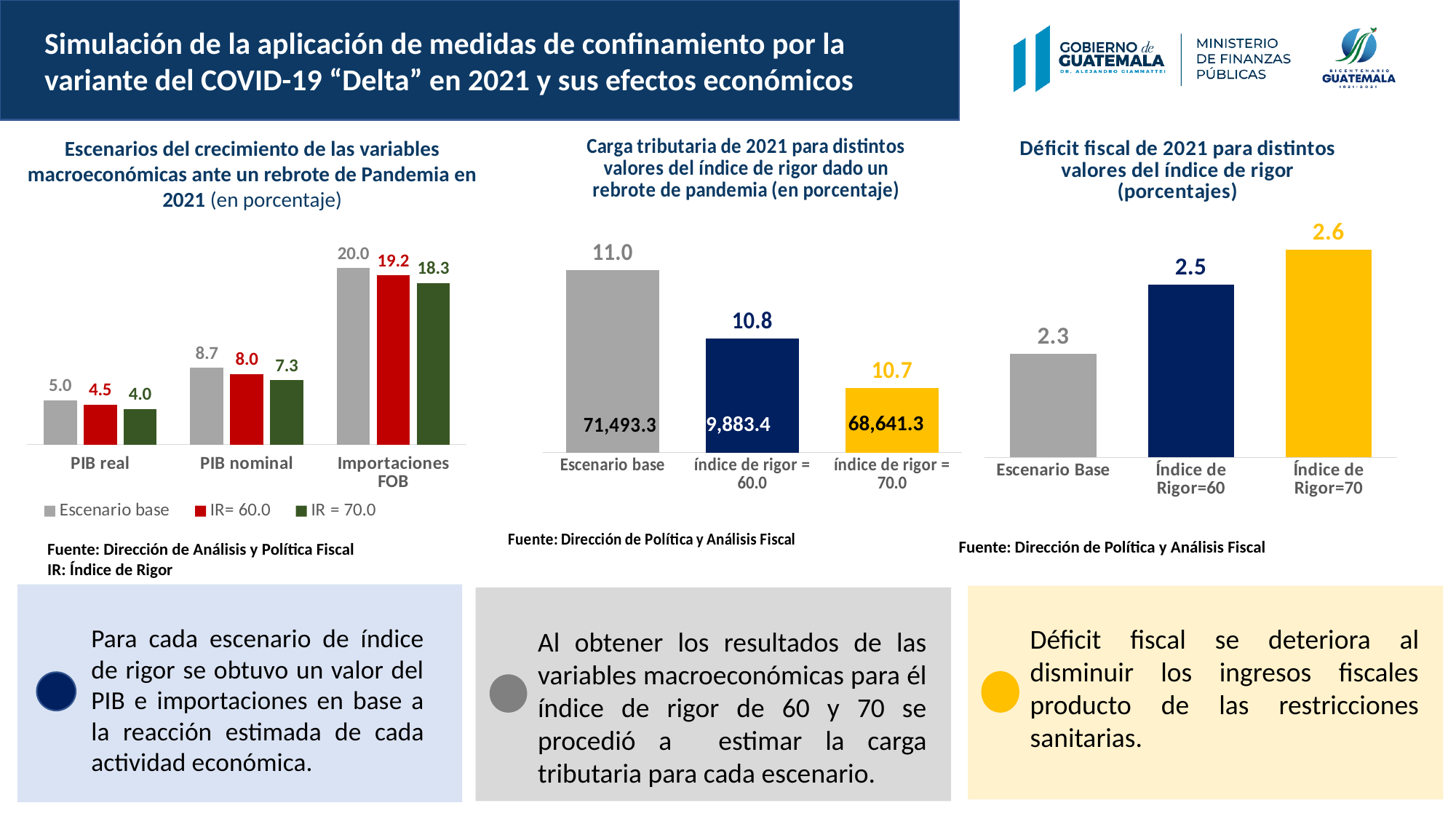
In the left chart (Escenarios del crecimiento de las variables macroeconómicas), which category has the highest values? Importaciones FOB In the middle chart (Carga tributaria de 2021), which category has the lowest value? índice de rigor = 70.0 In the left chart (Escenarios del crecimiento de las variables macroeconómicas), how many series does the legend list? 3 In the left chart (Escenarios del crecimiento de las variables macroeconómicas), what colour are the IR= 60.0 bars? Red In the middle chart (Carga tributaria de 2021), do the values rise or fall from Escenario base to índice de rigor = 70.0? Fall In the left chart (Escenarios del crecimiento de las variables macroeconómicas), what is the value for Importaciones FOB in the Escenario base series? 20.0 What kind of chart is the right chart (Déficit fiscal de 2021)? Bar chart In the right chart (Déficit fiscal de 2021), what is the value for Índice de Rigor=60? 2.5 In the left chart (Escenarios del crecimiento de las variables macroeconómicas), what is the value for PIB nominal in the IR = 70.0 series? 7.3 In the middle chart (Carga tributaria de 2021), what is the value for Escenario base? 11.0 In the left chart (Escenarios del crecimiento de las variables macroeconómicas), what is the difference between the Escenario base and IR= 60.0 values for PIB real? 0.5 In the right chart (Déficit fiscal de 2021), what is the difference between Índice de Rigor=70 and Escenario Base? 0.3